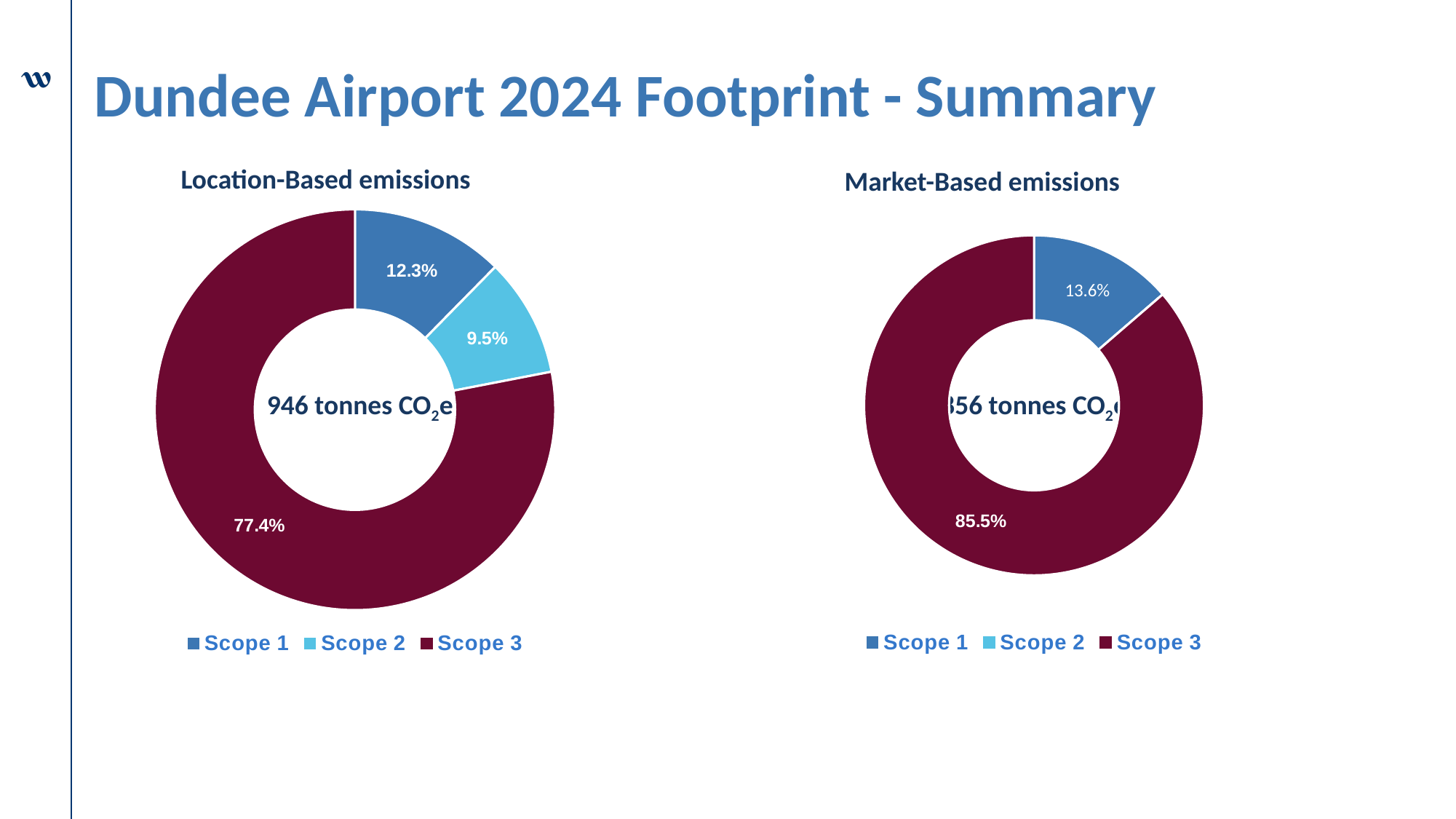
In the Location-Based emissions chart, which scope has the largest share? Scope 3 How many entries does the legend of the Location-Based emissions chart list? 3 Which chart shows a larger share for Scope 3, Location-Based emissions or Market-Based emissions? Market-Based emissions In the Location-Based emissions chart, what share of emissions is Scope 2? 9.5% In the Market-Based emissions chart, what share of emissions is Scope 3? 85.5% What total is shown in the centre of the Location-Based emissions chart? 946 tonnes CO2e In the Location-Based emissions chart, what share of emissions is Scope 3? 77.4% In the Market-Based emissions chart, what share of emissions is Scope 1? 13.6% In the Location-Based emissions chart, what is the difference in percentage points between Scope 1 and Scope 2? 2.8 In the Location-Based emissions chart, which scope has the smallest share? Scope 2 What type of chart is the Market-Based emissions chart? Doughnut chart In the Location-Based emissions chart, what share of emissions is Scope 1? 12.3%